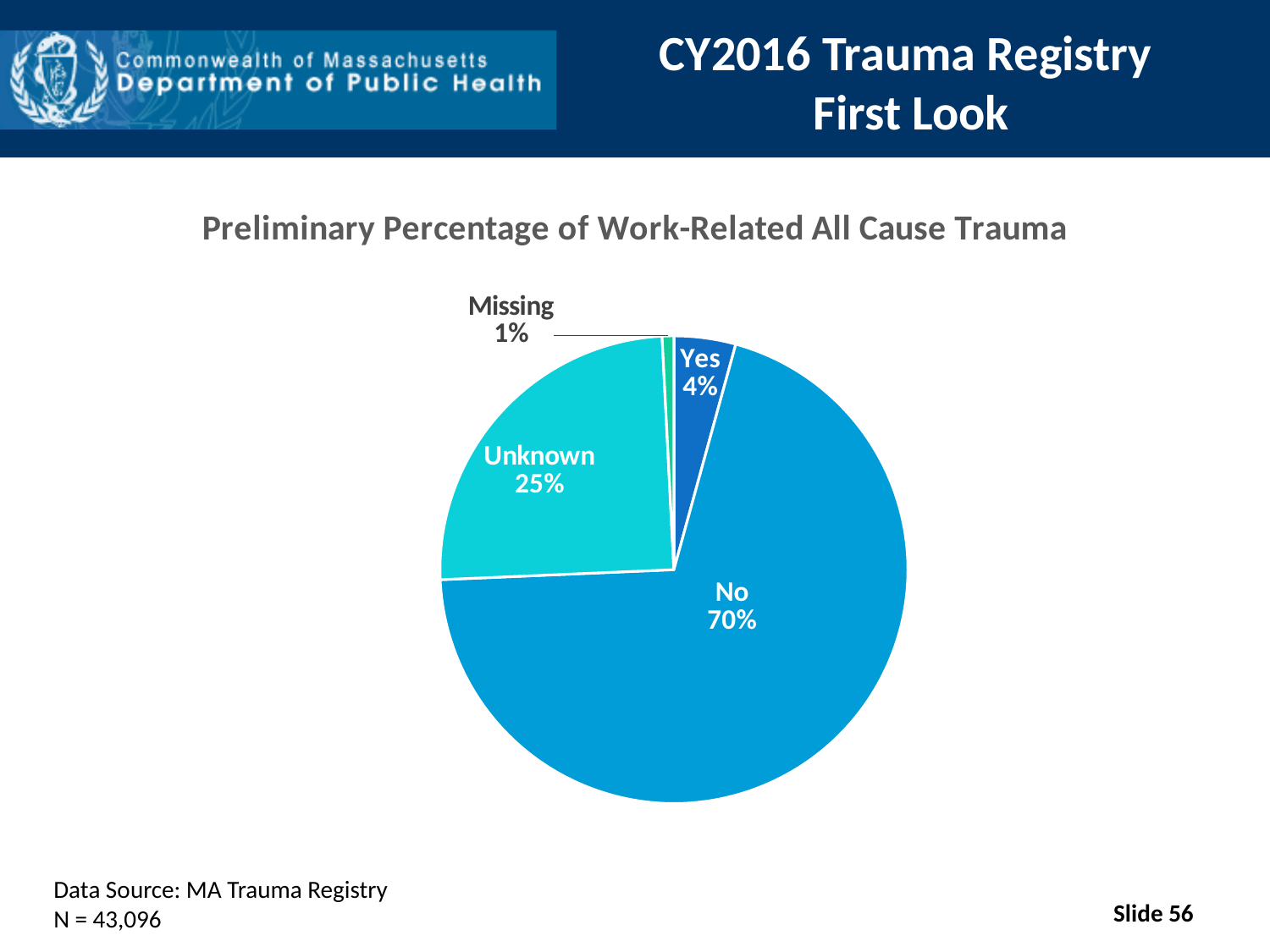
What percentage of the pie is labelled "No"? 70% Which category has the smallest slice of the pie? Missing What type of chart is shown on the slide? Pie chart What percentage of the pie is labelled "Yes"? 4% What percentage of the pie is labelled "Unknown"? 25% What is the difference in percentage points between the "No" and "Unknown" slices? 45 How many slices does the pie chart have? 4 What percentage of the pie is labelled "Missing"? 1% Which slice is larger, "Yes" or "Unknown"? Unknown What is the N value stated below the chart? 43,096 What is the title of the chart? Preliminary Percentage of Work-Related All Cause Trauma Which category has the largest slice of the pie? No